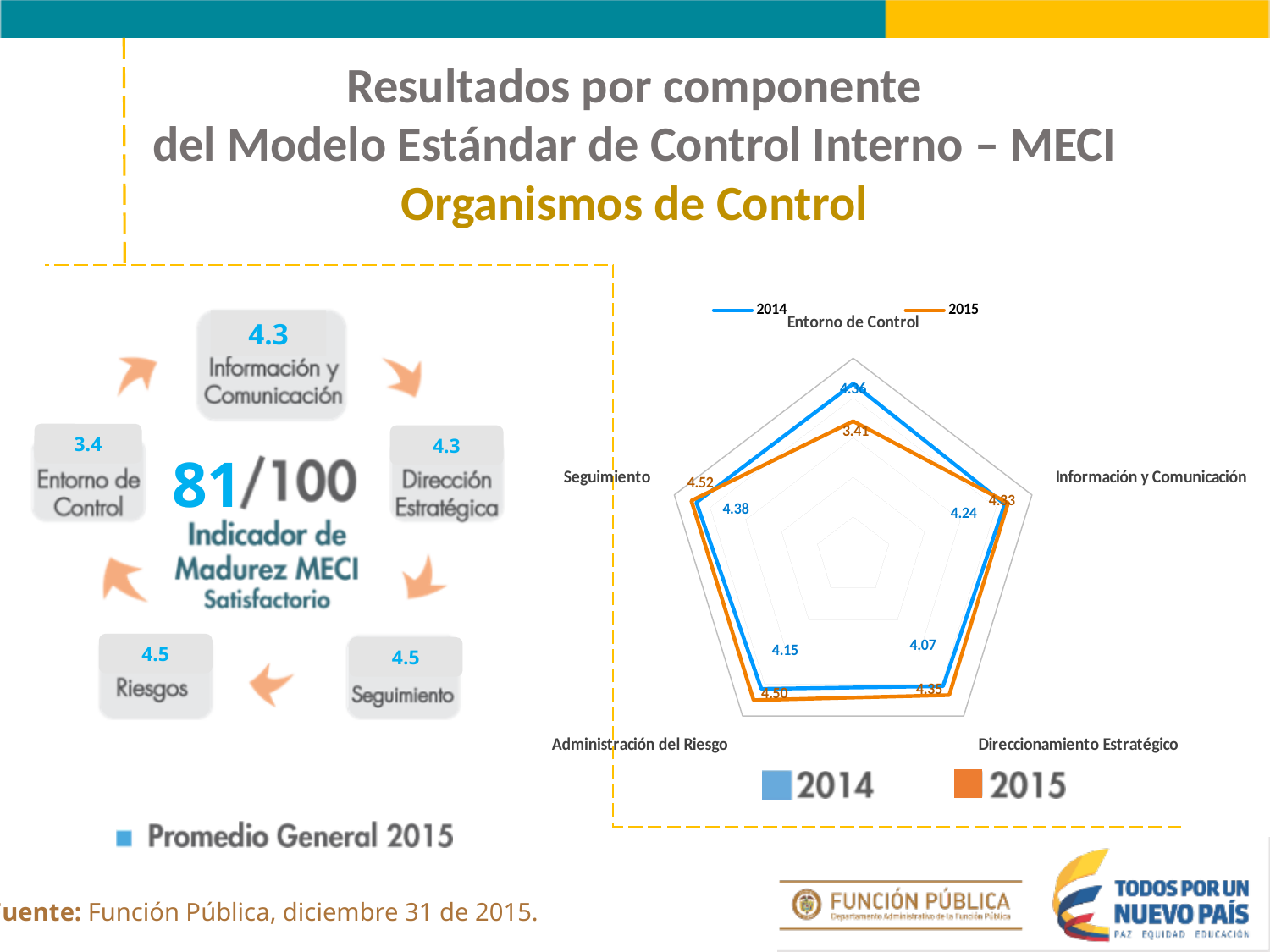
What kind of chart is shown on the right side of the slide? radar chart In the radar chart, what is the difference between the 2015 and 2014 values for Administración del Riesgo? 0.35 In the radar chart, what is the 2014 value for Administración del Riesgo? 4.15 In the radar chart, for Información y Comunicación, which year has the larger value, 2014 or 2015? 2015 In the radar chart, what is the 2015 value for Seguimiento? 4.52 How many components (axes) does the radar chart have? 5 In the radar chart, which component has the lowest 2015 value? Entorno de Control In the radar chart, what is the 2014 value for Direccionamiento Estratégico? 4.07 In the radar chart, which component has the lowest 2014 value? Direccionamiento Estratégico In the radar chart, what is the 2015 value for Entorno de Control? 3.41 How many series does the legend of the radar chart list? 2 What are the two series named in the legend of the radar chart? 2014 and 2015